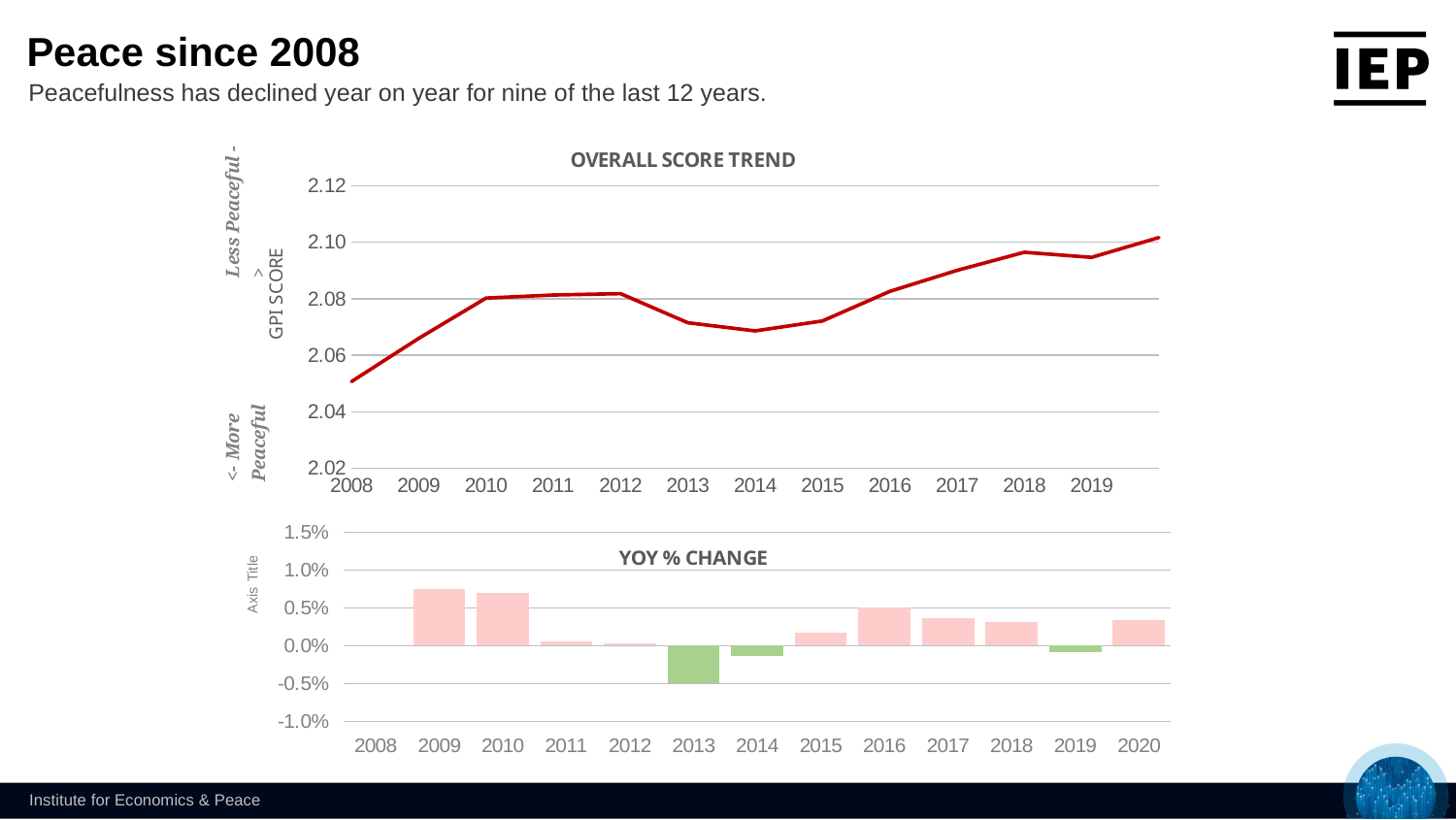
In the OVERALL SCORE TREND chart, which is larger, the value for 2008 or the value for 2019? 2019 What kind of chart is the YOY % CHANGE chart? bar chart In the YOY % CHANGE chart, is the value for 2013 greater or less than 0.0%? less In the OVERALL SCORE TREND chart, which year has the lowest GPI score? 2008 In the YOY % CHANGE chart, which year has the lowest value? 2013 In the YOY % CHANGE chart, which is larger, the value for 2016 or the value for 2017? 2016 How many years are shown on the x axis of the YOY % CHANGE chart? 13 What kind of chart is the OVERALL SCORE TREND chart? line chart In the YOY % CHANGE chart, is the value for 2009 greater or less than 0.5%? greater In the OVERALL SCORE TREND chart, is the value for 2018 greater or less than 2.08? greater